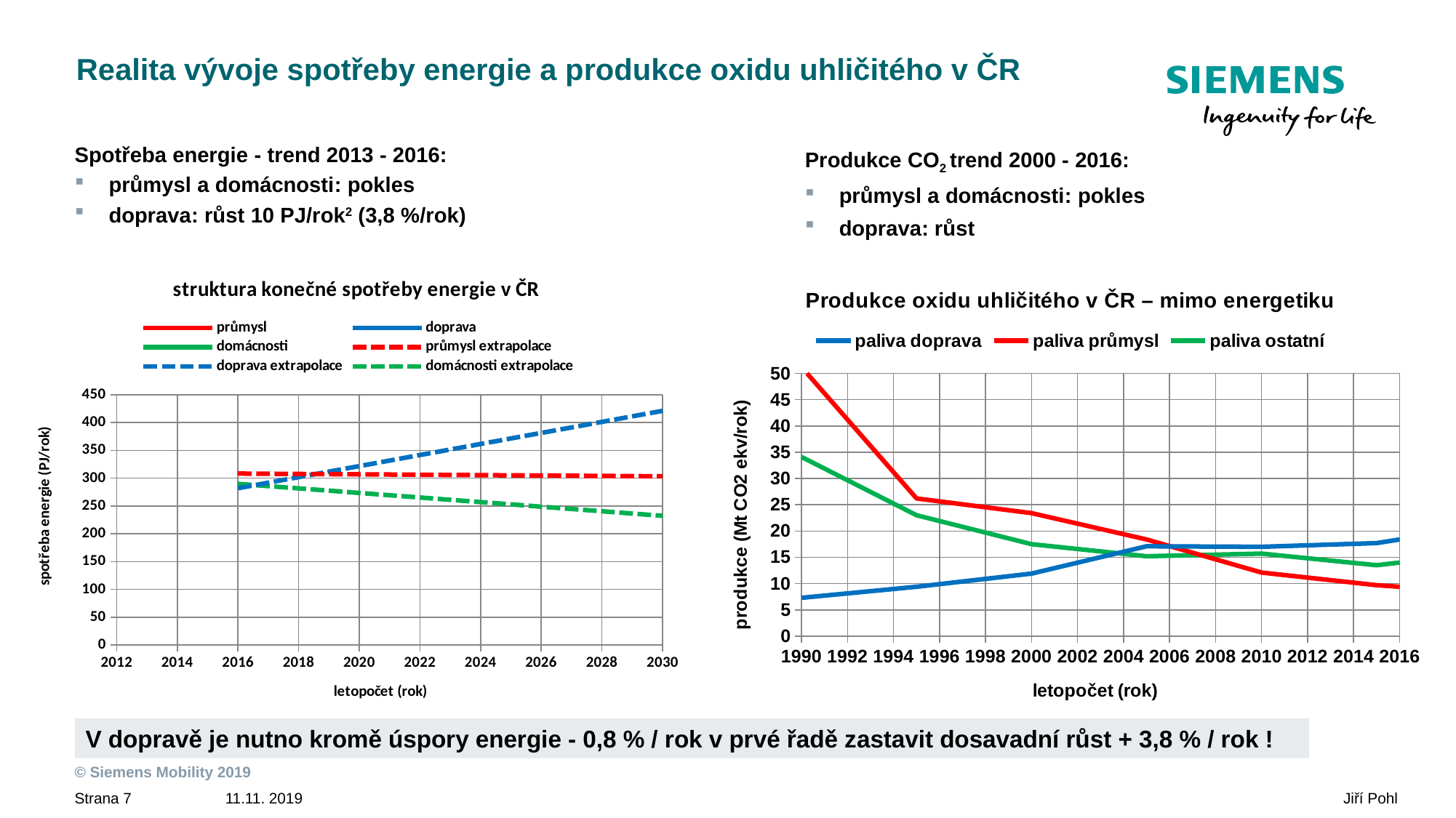
In the chart titled "Produkce oxidu uhličitého v ČR – mimo energetiku", does the paliva doprava series rise or fall from 1990 to 2016? rise In the chart titled "Produkce oxidu uhličitého v ČR – mimo energetiku", is the value for paliva doprava in 1990 greater or less than 10? less How many series does the legend of the chart titled "struktura konečné spotřeby energie v ČR" list? 6 In the chart titled "struktura konečné spotřeby energie v ČR", is the value for doprava extrapolace in 2030 greater or less than 400? greater In the chart titled "Produkce oxidu uhličitého v ČR – mimo energetiku", does the paliva průmysl series rise or fall from 1990 to 2016? fall How many series does the legend of the chart titled "Produkce oxidu uhličitého v ČR – mimo energetiku" list? 3 What kind of chart is the chart titled "Produkce oxidu uhličitého v ČR – mimo energetiku"? line chart In the chart titled "Produkce oxidu uhličitého v ČR – mimo energetiku", is the value for paliva průmysl in 2016 greater or less than 15? less In the chart titled "struktura konečné spotřeby energie v ČR", what is the label of the y axis? spotřeba energie (PJ/rok) In the chart titled "Produkce oxidu uhličitého v ČR – mimo energetiku", which series has the higher value in 2016, paliva doprava or paliva průmysl? paliva doprava